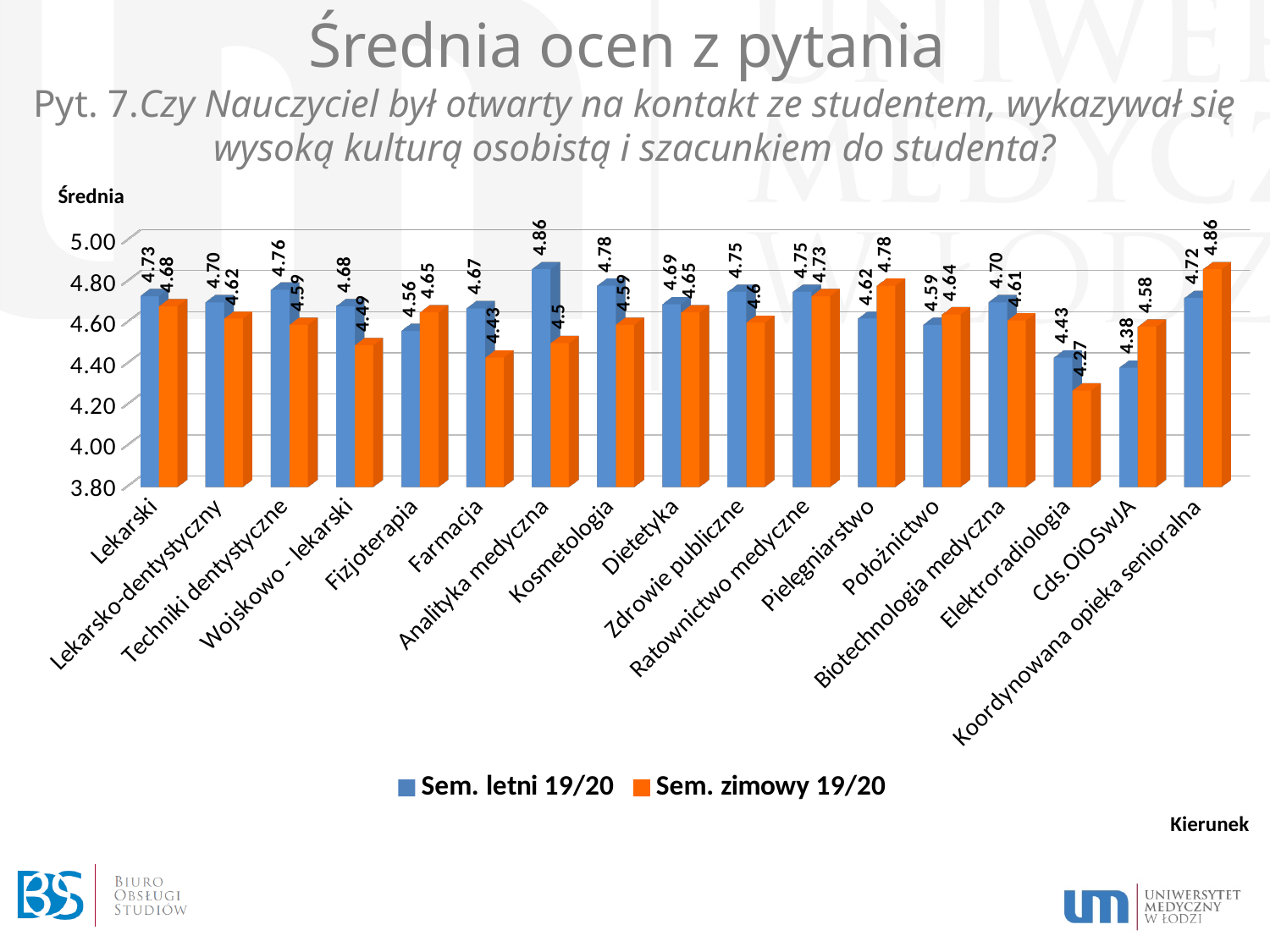
Which category has the highest value in the Sem. letni 19/20 series? Analityka medyczna How many series does the legend list? 2 What is the difference between the Sem. letni 19/20 and Sem. zimowy 19/20 values for Analityka medyczna? 0.36 For Koordynowana opieka senioralna, which series has the larger value: Sem. letni 19/20 or Sem. zimowy 19/20? Sem. zimowy 19/20 What is the value for Analityka medyczna in the Sem. letni 19/20 series? 4.86 What kind of chart is shown on the slide? bar chart Which category has the lowest value in the Sem. zimowy 19/20 series? Elektroradiologia How many categories (kierunki) are shown on the x axis? 17 Is the Sem. zimowy 19/20 value for Farmacja greater or less than 4.60? less Which category has the lowest value in the Sem. letni 19/20 series? Cds.OiOSwJA What is the value for Elektroradiologia in the Sem. zimowy 19/20 series? 4.27 What is the Sem. zimowy 19/20 value for Pielęgniarstwo? 4.78